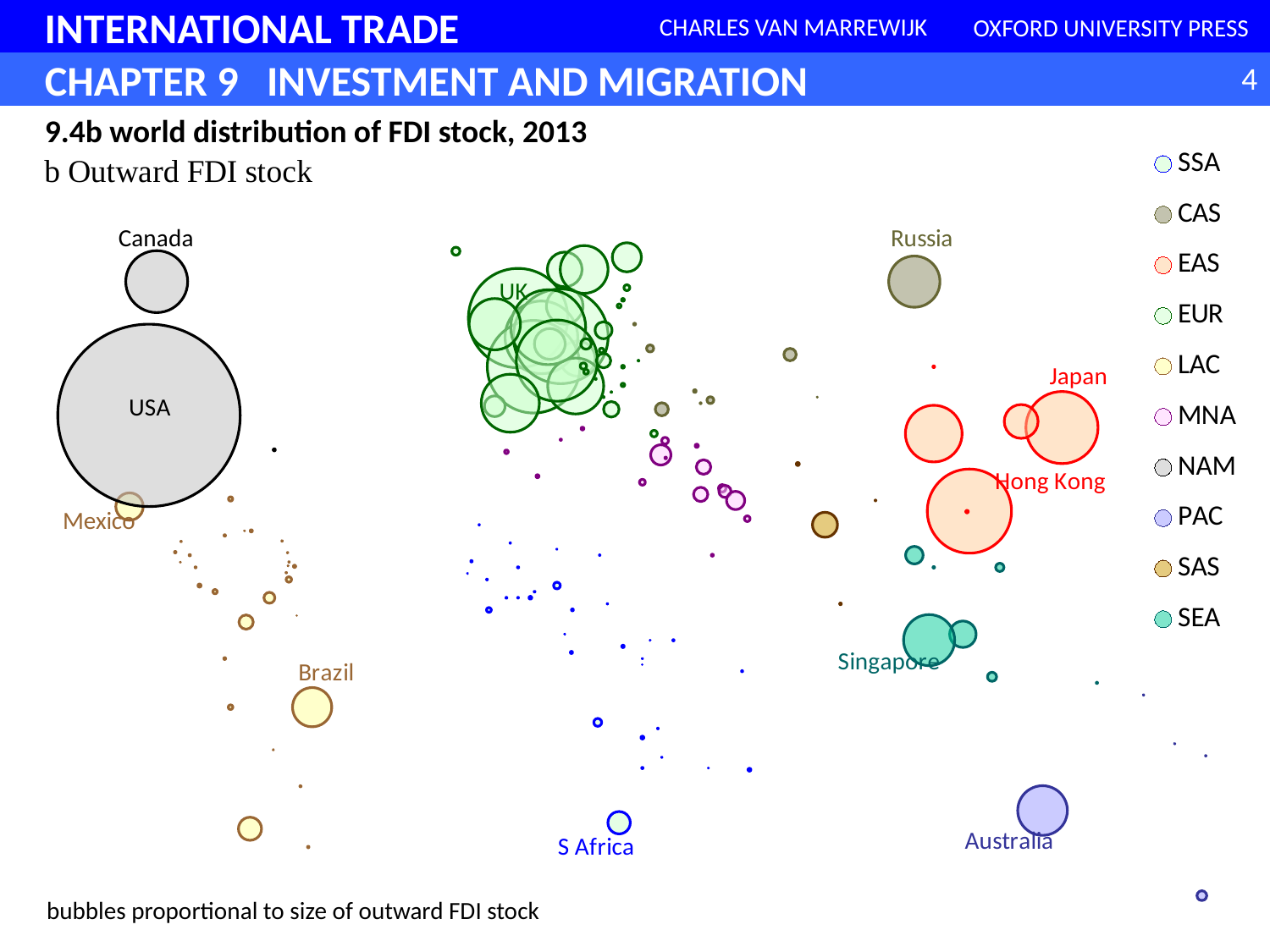
How many countries are labelled by name on the chart? 11 What kind of chart is shown on the slide? bubble chart Which bubble is larger, Brazil or Mexico? Brazil How many regions does the legend list? 10 Which bubble is larger, USA or Canada? USA Which bubble is larger, USA or UK? USA What is the title of the chart? 9.4b world distribution of FDI stock, 2013 Which country has the largest bubble for outward FDI stock? USA According to the note below the chart, what are the bubbles proportional to? size of outward FDI stock